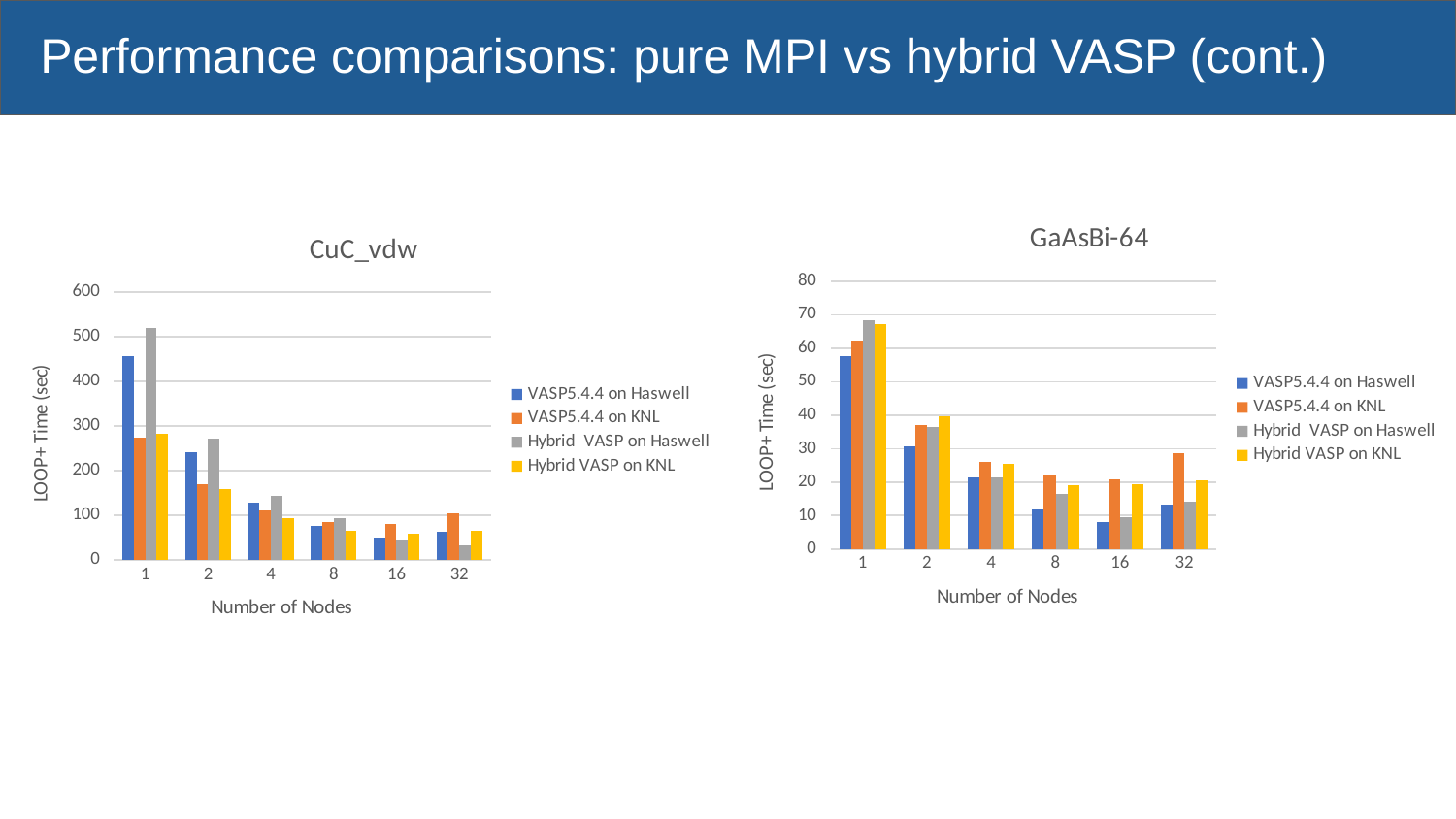
In the GaAsBi-64 chart, is the value for VASP5.4.4 on KNL at 1 node greater or less than 60? greater In the CuC_vdw chart, does the LOOP+ Time for Hybrid VASP on Haswell rise or fall as the number of nodes increases? fall In the GaAsBi-64 chart, which series has the lowest LOOP+ Time at 1 node? VASP5.4.4 on Haswell In the GaAsBi-64 chart, is the value for VASP5.4.4 on Haswell at 16 nodes greater or less than 10? less In the CuC_vdw chart at 32 nodes, which is larger: VASP5.4.4 on KNL or Hybrid VASP on Haswell? VASP5.4.4 on KNL What is the y-axis label of the GaAsBi-64 chart? LOOP+ Time (sec) In the GaAsBi-64 chart at 32 nodes, which is larger: VASP5.4.4 on KNL or VASP5.4.4 on Haswell? VASP5.4.4 on KNL How many series does the legend of the GaAsBi-64 chart list? 4 In the CuC_vdw chart, is the value for VASP5.4.4 on Haswell at 1 node greater or less than 400? greater In the CuC_vdw chart, how many node counts are shown on the x axis? 6 What type of chart is the CuC_vdw chart on the left? bar chart In the CuC_vdw chart, which series has the highest LOOP+ Time at 1 node? Hybrid VASP on Haswell